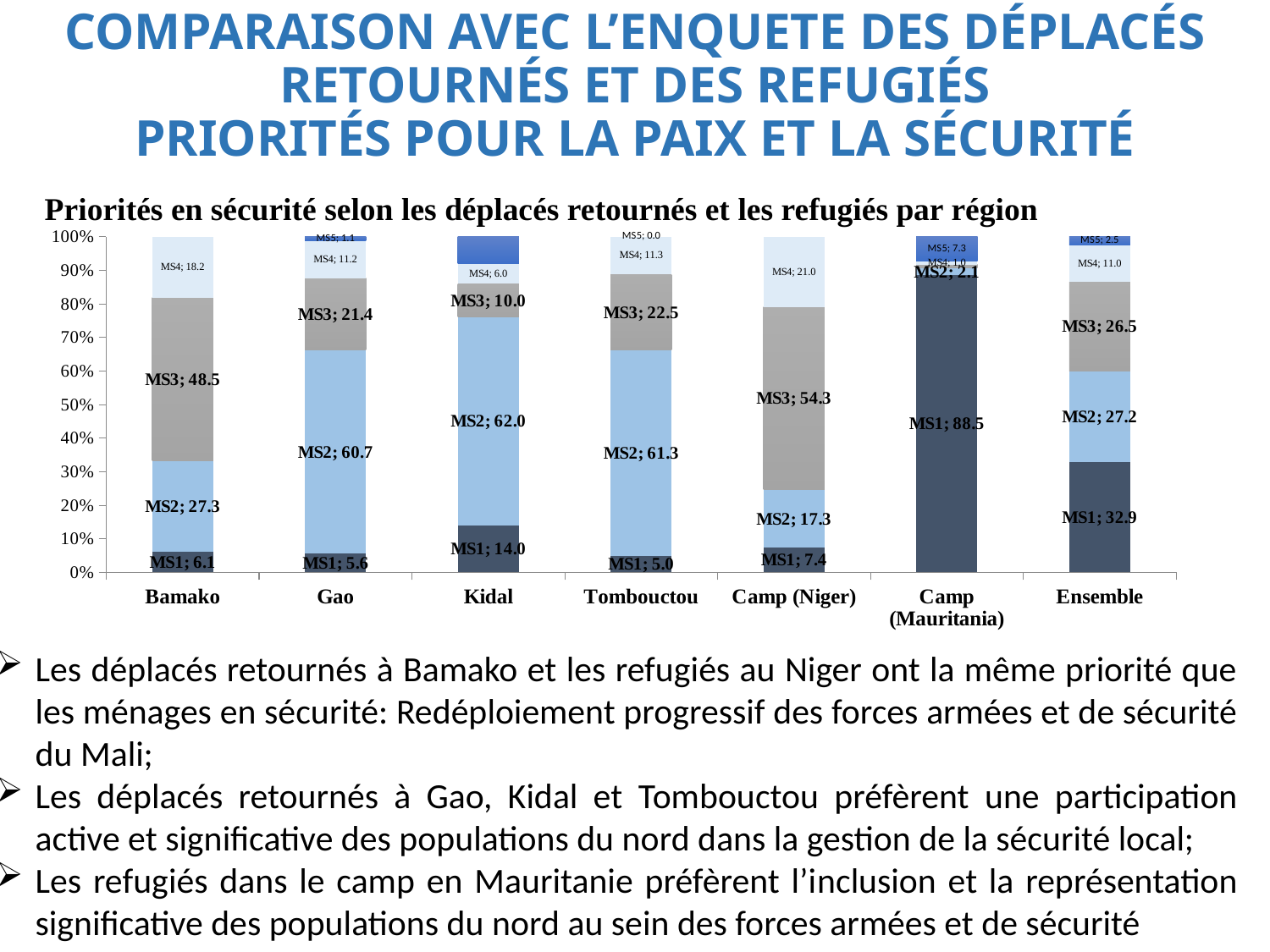
Which is larger, the MS3 value for Tombouctou or the MS3 value for Gao? Tombouctou How many regions (categories) are shown on the x axis of the chart? 7 What is the MS2 value for Kidal? 62.0 What type of chart is shown on the slide? stacked bar chart Which region has the highest MS1 value? Camp (Mauritania) Which region has the lowest MS1 value? Tombouctou What is the MS3 value for Bamako? 48.5 What is the MS4 value for Camp (Niger)? 21.0 What is the title of the chart? Priorités en sécurité selon les déplacés retournés et les refugiés par région Which region has the highest MS3 value? Camp (Niger) What is the MS1 value for Camp (Mauritania)? 88.5 What is the difference between the MS2 values for Kidal and Gao? 1.3